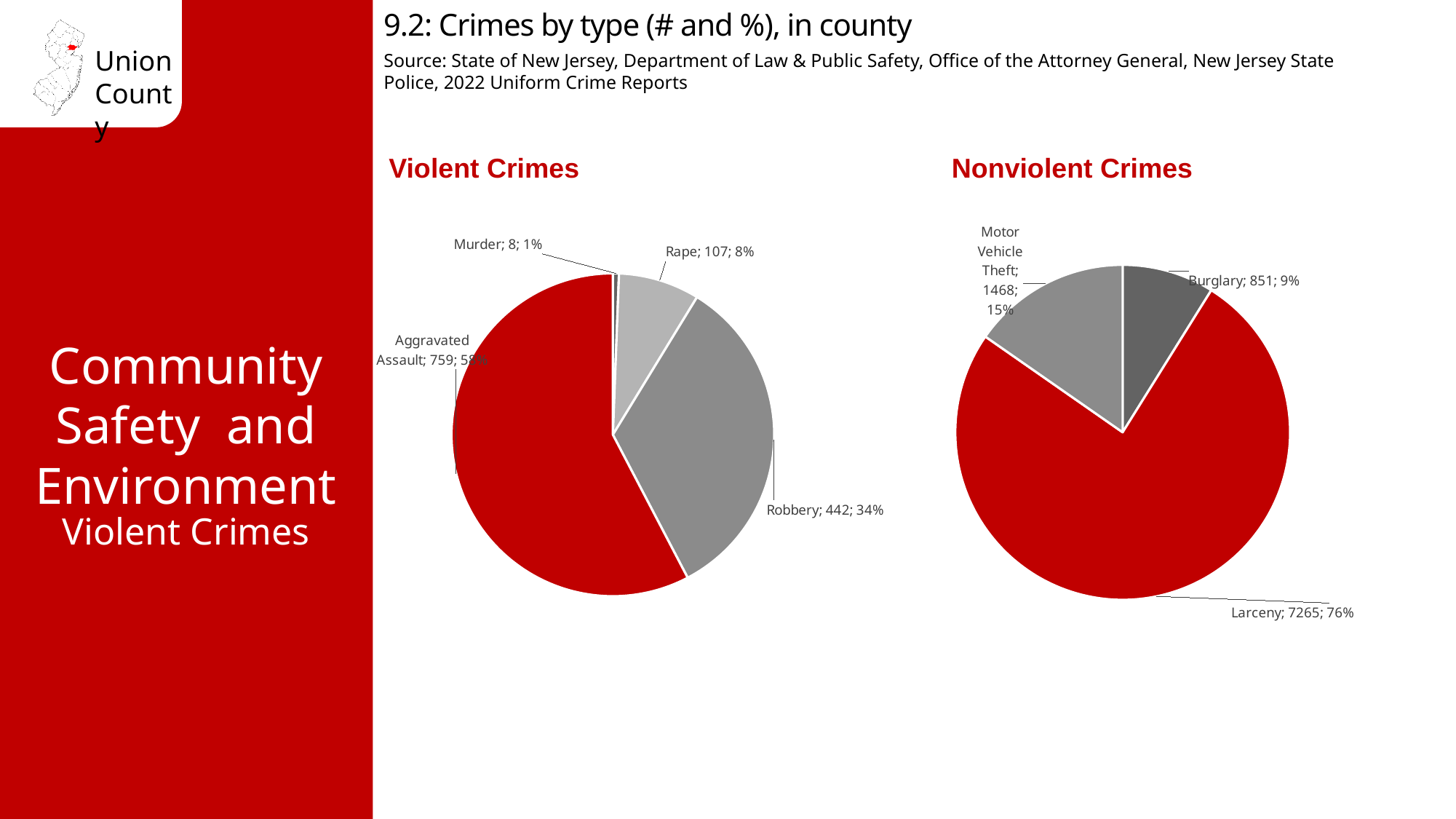
In the Nonviolent Crimes chart, how many larcenies are shown? 7265 How many slices does the Nonviolent Crimes pie chart have? 3 What kind of chart is the Violent Crimes chart? Pie chart In the Nonviolent Crimes chart, what is the difference between the number of motor vehicle thefts and burglaries? 617 In the Nonviolent Crimes chart, what share of nonviolent crimes is motor vehicle theft? 15% In the Violent Crimes chart, how many robberies are shown? 442 In the Nonviolent Crimes chart, which is larger, burglary or motor vehicle theft? Motor Vehicle Theft In the Violent Crimes chart, how many murders are shown? 8 In the Violent Crimes chart, which crime type has the largest slice? Aggravated Assault In the Violent Crimes chart, what is the difference between the number of aggravated assaults and the number of robberies? 317 In the Violent Crimes chart, which crime type has the smallest slice? Murder In the Violent Crimes chart, what percentage of violent crimes is rape? 8%